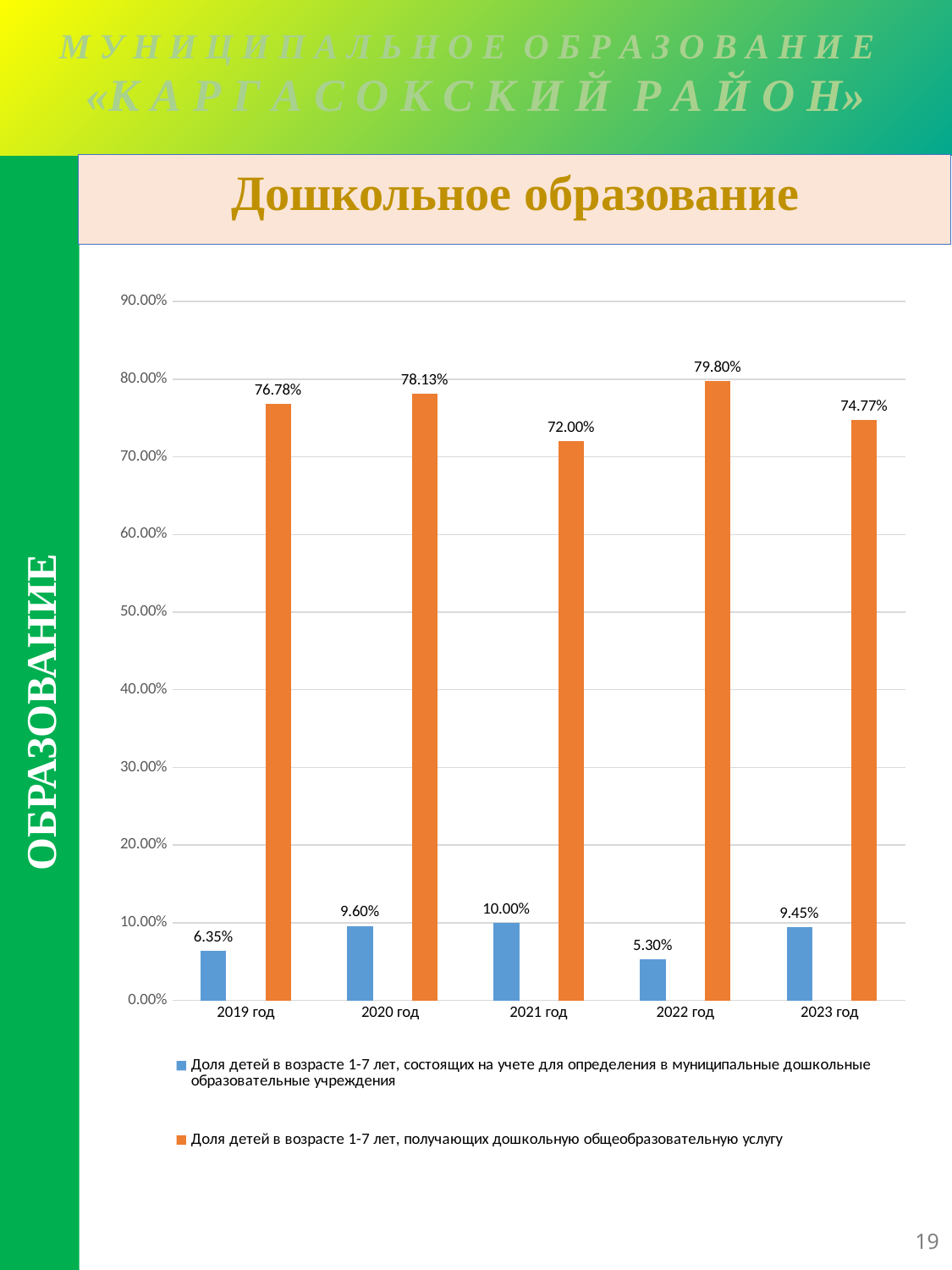
How many series does the chart legend list? 2 How many years are shown on the x axis of the chart? 5 What is the difference between the blue series values for 2021 год and 2022 год? 4.70% In which year is the share of children receiving preschool general education services (orange series) the highest? 2022 год Which is larger: the orange series value for 2020 год or for 2023 год? 2020 год In which year is the share of children registered for placement in preschool institutions (blue series) the lowest? 2022 год What type of chart is shown on the slide? bar chart Is the blue series value for 2021 год greater or less than 20.00%? less What is the share of children aged 1-7 registered for placement in municipal preschool institutions (blue series) in 2019 год? 6.35% What is the share of children aged 1-7 receiving preschool general education services (orange series) in 2022 год? 79.80% What is the difference between the orange series values for 2022 год and 2021 год? 7.80% What is the value of the orange series (children receiving preschool services) for 2021 год? 72.00%